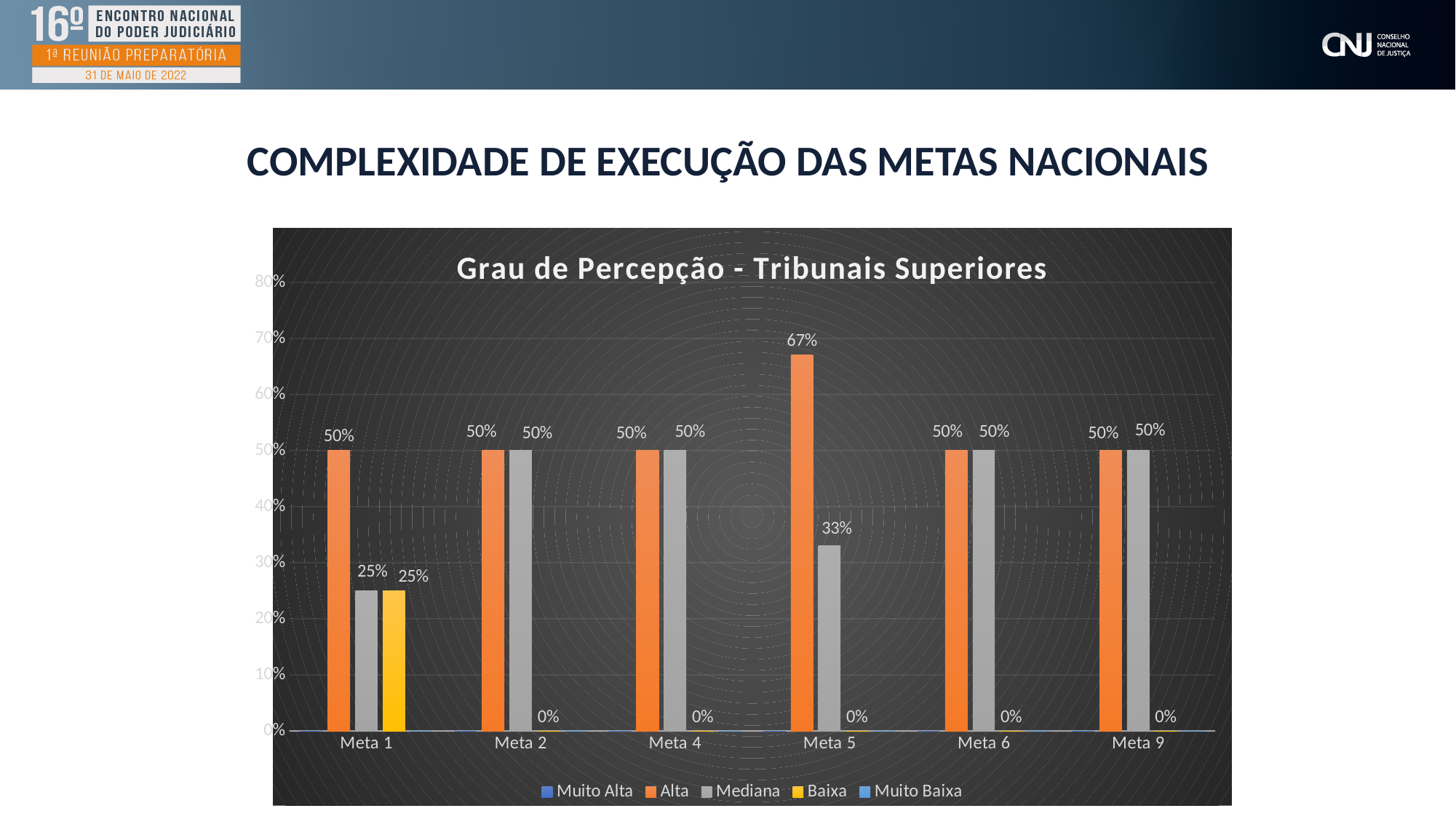
How many series does the legend list? 5 Which Meta has the highest value for the Alta series? Meta 5 For Meta 1, which is larger: the Alta value or the Mediana value? Alta What kind of chart is shown on the slide? bar chart How many categories (Metas) are shown on the x axis? 6 What is the value of the Baixa series for Meta 1? 25% What is the difference between the Alta and Mediana values for Meta 5? 34% What is the title of the chart? Grau de Percepção - Tribunais Superiores What is the value of the Mediana series for Meta 5? 33% Is the Alta value for Meta 5 greater or less than 60%? greater What is the value of the Alta series for Meta 5? 67% Which Meta has the lowest value for the Mediana series? Meta 1